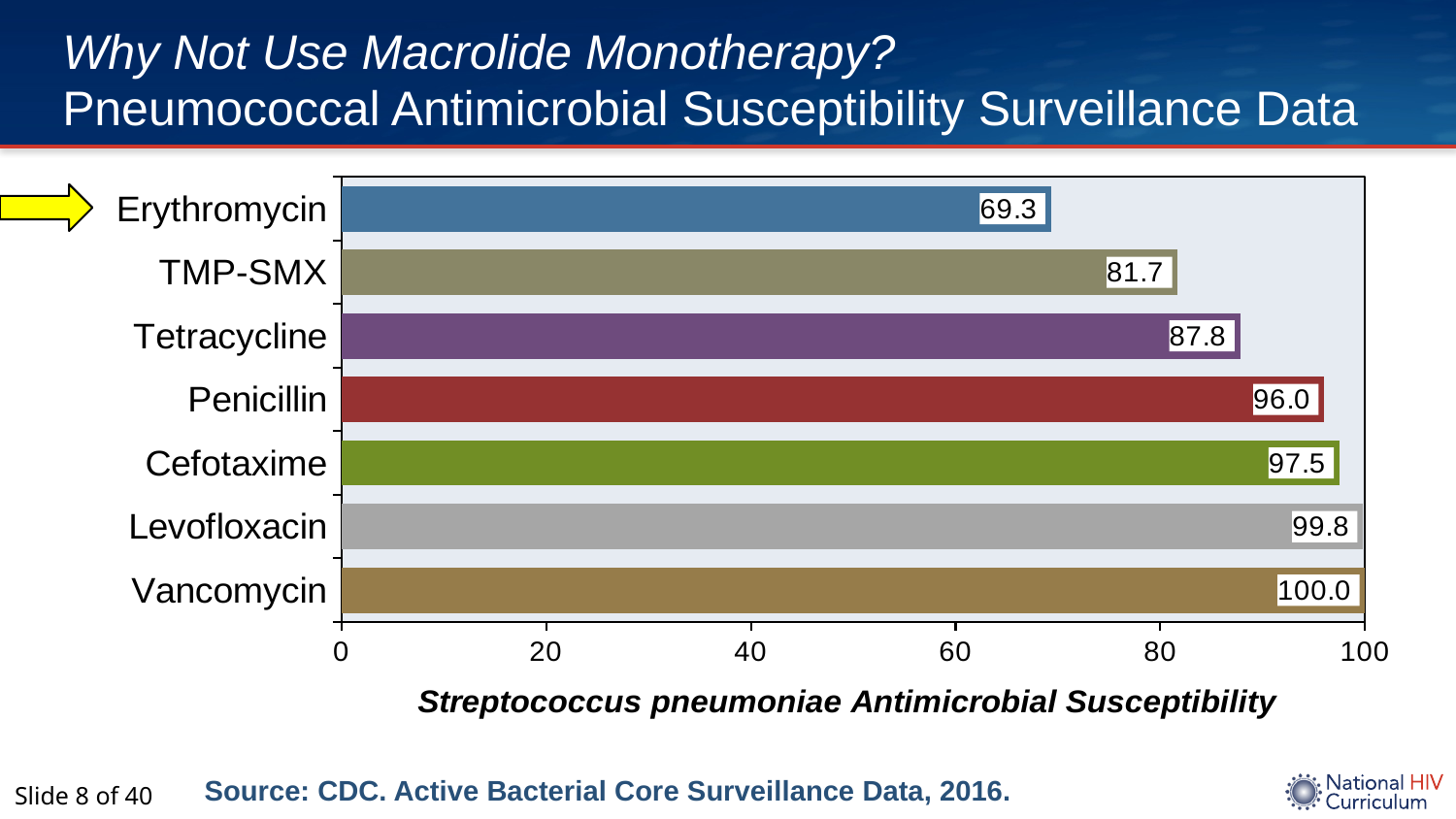
What is the x-axis label of the chart? Streptococcus pneumoniae Antimicrobial Susceptibility Is the value for Erythromycin greater or less than 80? less Which antimicrobial has the lowest susceptibility value? Erythromycin What is the difference between the values for Cefotaxime and Tetracycline? 9.7 Which antimicrobial has the highest susceptibility value? Vancomycin What kind of chart is shown on the slide? Bar chart What is the susceptibility value shown for Penicillin? 96.0 What is the susceptibility value shown for Erythromycin? 69.3 How many antimicrobials are shown in the chart? 7 What is the susceptibility value shown for TMP-SMX? 81.7 Which has a higher susceptibility value, Tetracycline or TMP-SMX? Tetracycline What is the difference between the values for Vancomycin and Erythromycin? 30.7